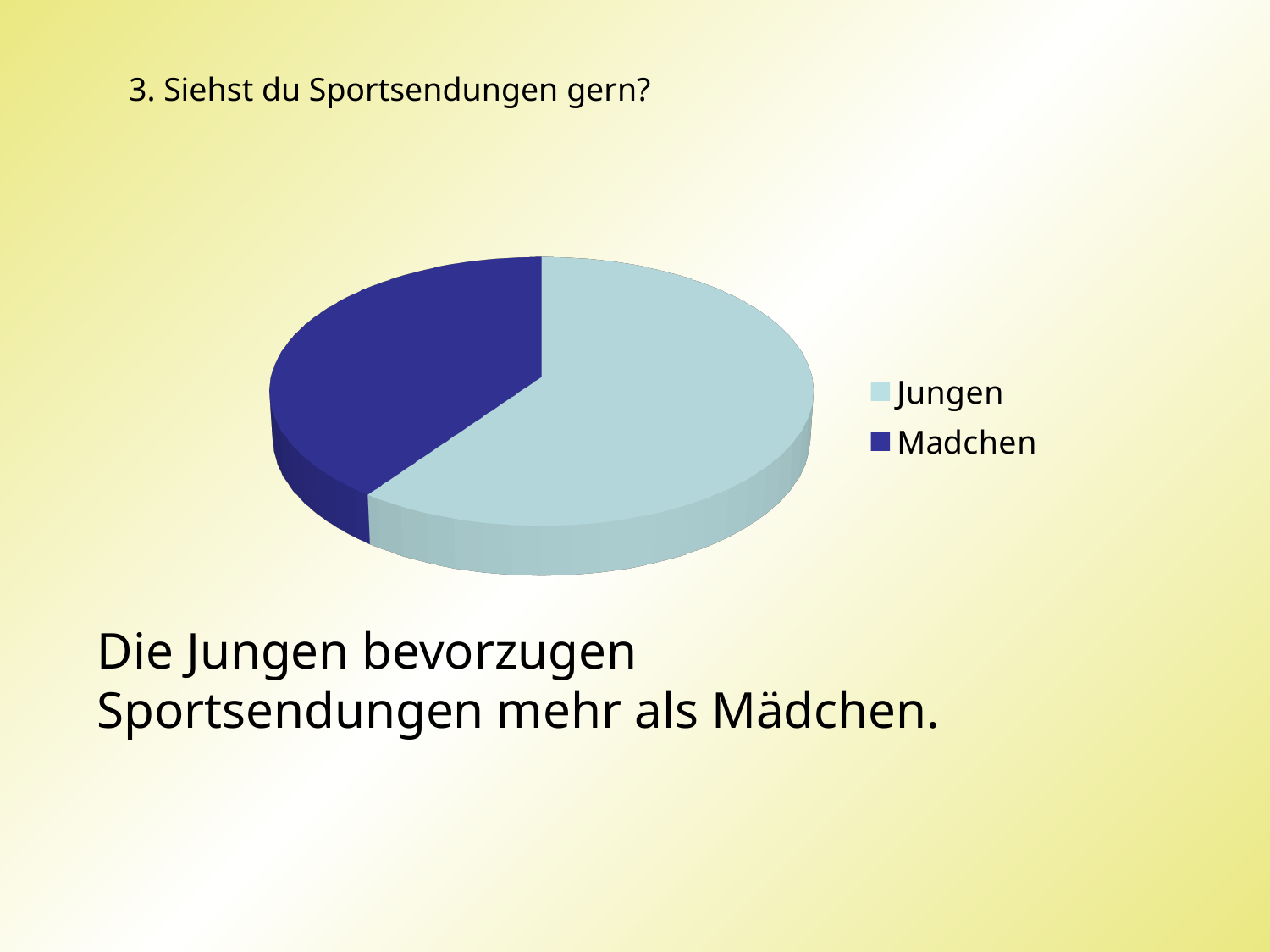
Which slice of the pie chart is the largest? Jungen What kind of chart is shown on the slide? pie chart What colour is the Madchen slice in the pie chart? dark blue Which slice is larger in the pie chart, Jungen or Madchen? Jungen Does the Jungen slice take up more or less than half of the pie chart? more How many entries does the legend of the pie chart list? 2 Which slice of the pie chart is the smallest? Madchen How many slices does the pie chart have? 2 What are the two legend entries of the pie chart? Jungen and Madchen